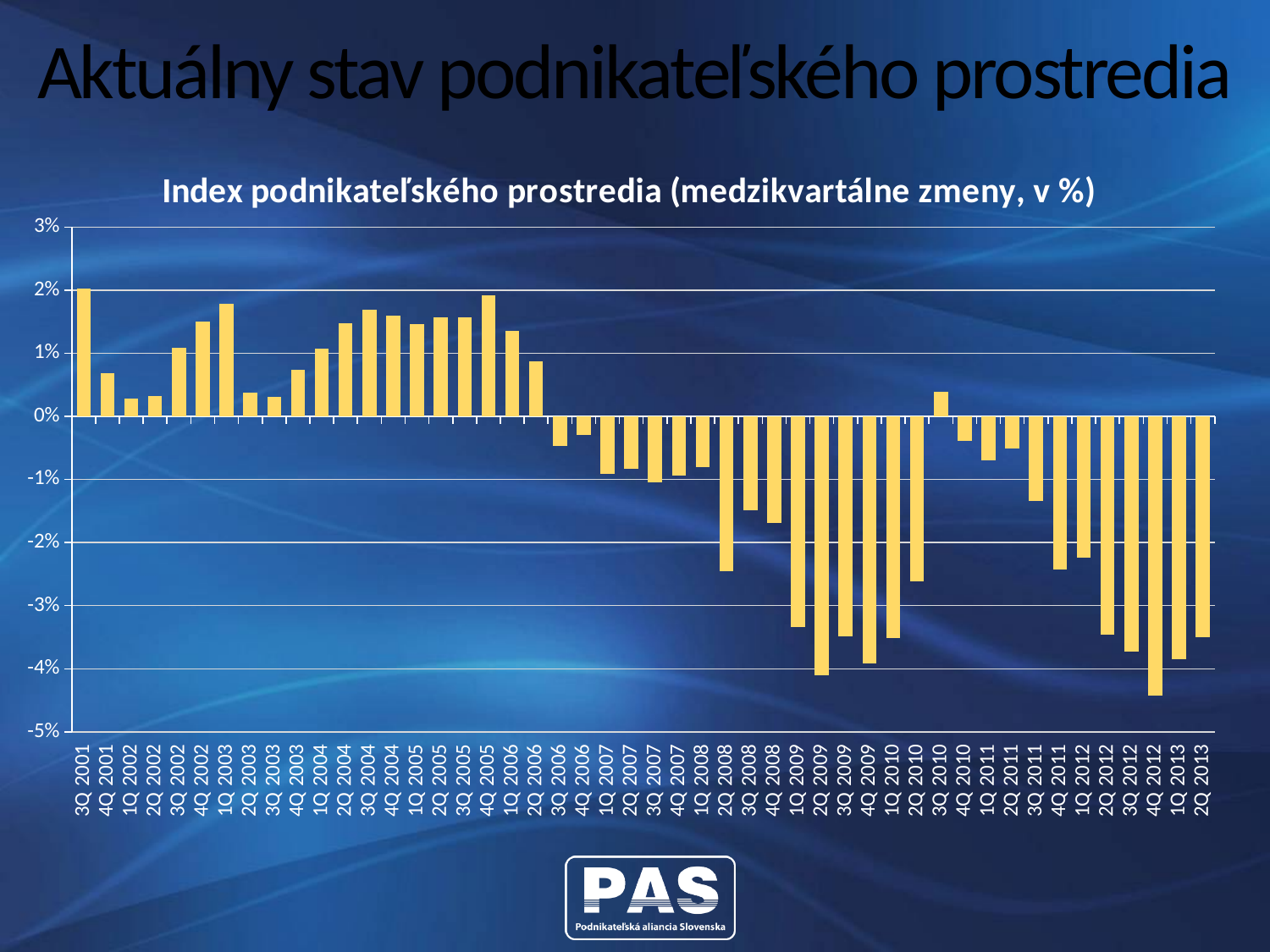
Is the value for 2Q 2008 greater or less than -2%? less Is the value for 3Q 2010 greater or less than 0%? greater How many quarters (bars) are plotted on the chart? 48 Which quarter has the lowest value on the chart? 4Q 2012 Is the value for 1Q 2003 greater or less than 1%? greater Do the values generally rise or fall from 1Q 2008 to 2Q 2009? fall Which is larger, the value for 1Q 2003 or the value for 2Q 2003? 1Q 2003 What is the title of the chart? Index podnikateľského prostredia (medzikvartálne zmeny, v %) What kind of chart is shown on the slide? bar chart